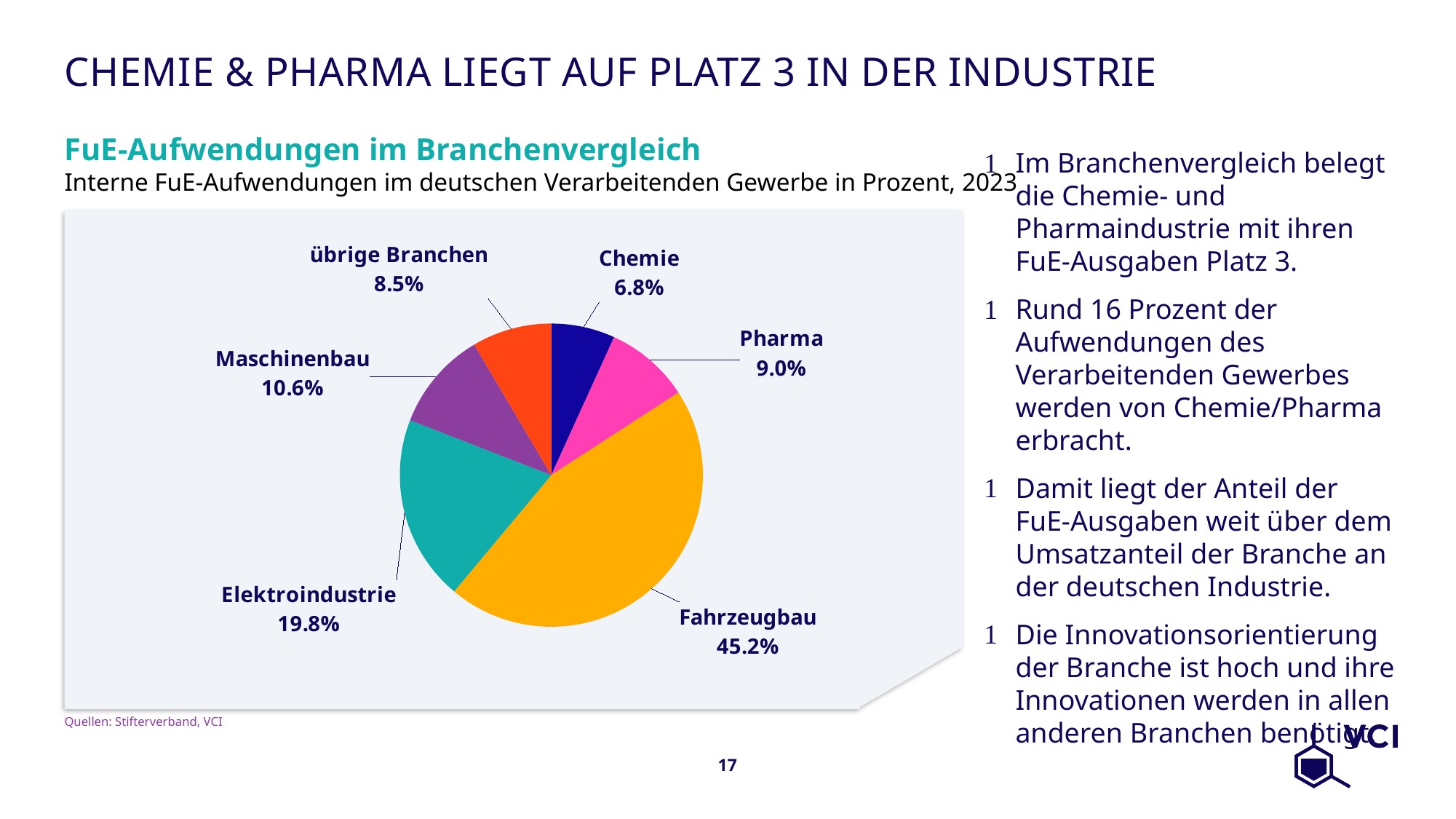
What is the value shown for Pharma? 9.0% What is the title of the chart? FuE-Aufwendungen im Branchenvergleich What type of chart is shown on the slide? pie chart Which sector has the smallest share in the pie chart? Chemie What is the value shown for Elektroindustrie? 19.8% Which is larger, the share of Maschinenbau or the share of übrige Branchen? Maschinenbau Which sector has the largest share in the pie chart? Fahrzeugbau What is the difference between the shares of Elektroindustrie and Maschinenbau? 9.2 percentage points What is the value shown for Chemie? 6.8% What is the combined share of Chemie and Pharma? 15.8% What share of internal R&D expenditure does Fahrzeugbau account for? 45.2% How many sectors (slices) are shown in the pie chart? 6